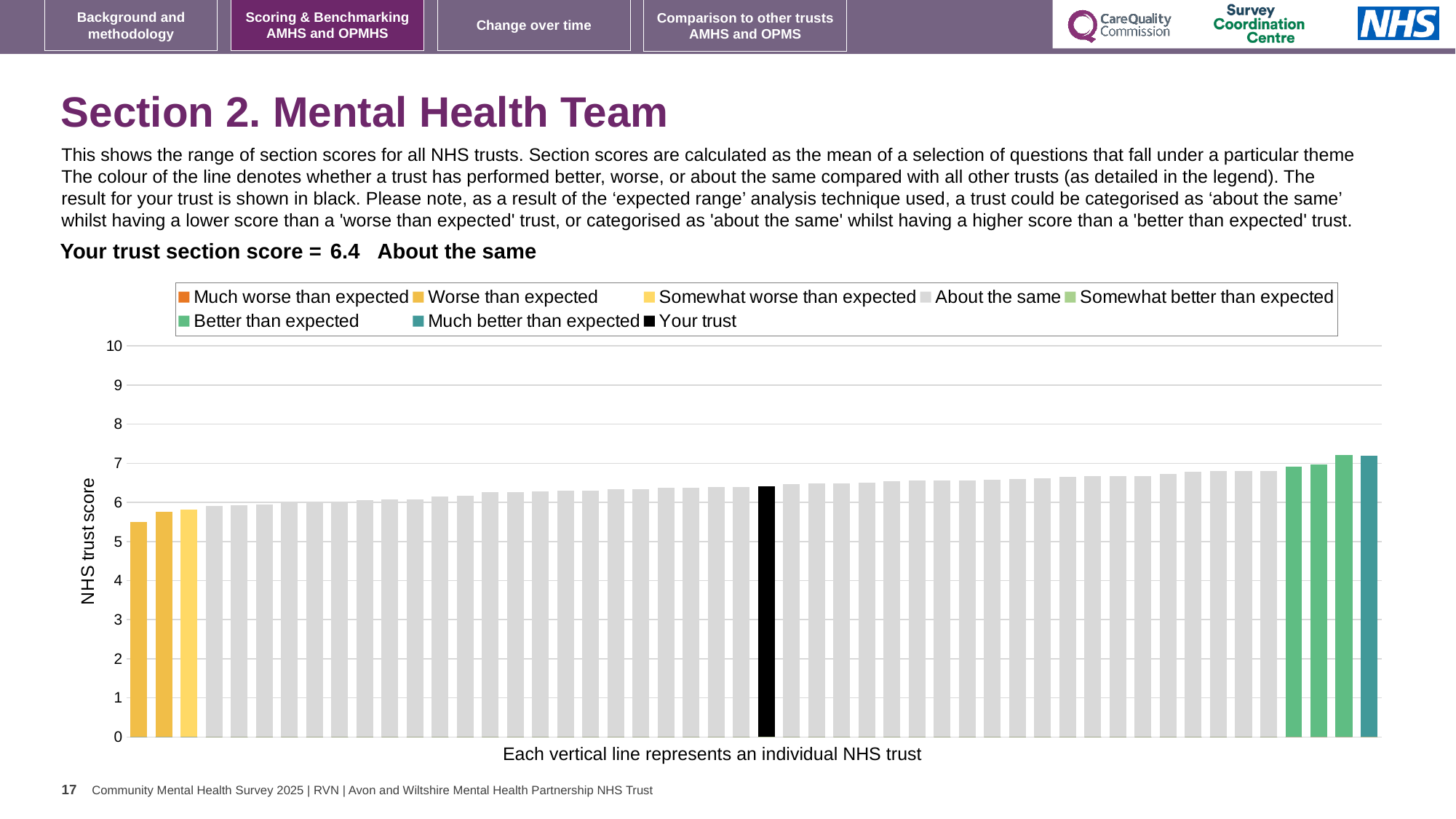
How many bars are coloured in the 'Worse than expected' yellow colour? 2 What is the label on the vertical axis of the chart? NHS trust score Is the value of the leftmost (lowest) bar greater or less than 6? less What is your trust's section score for Mental Health Team? 6.4 How many bars are coloured in the 'Much better than expected' teal colour? 1 Is the value of the rightmost bar greater or less than 6? greater Is the value of the black 'Your trust' bar greater or less than 6? greater Which category is your trust placed in for this section? About the same How many entries does the chart legend list? 8 What kind of chart is shown on the slide? bar chart Do the bar values rise or fall from left to right across the chart? rise